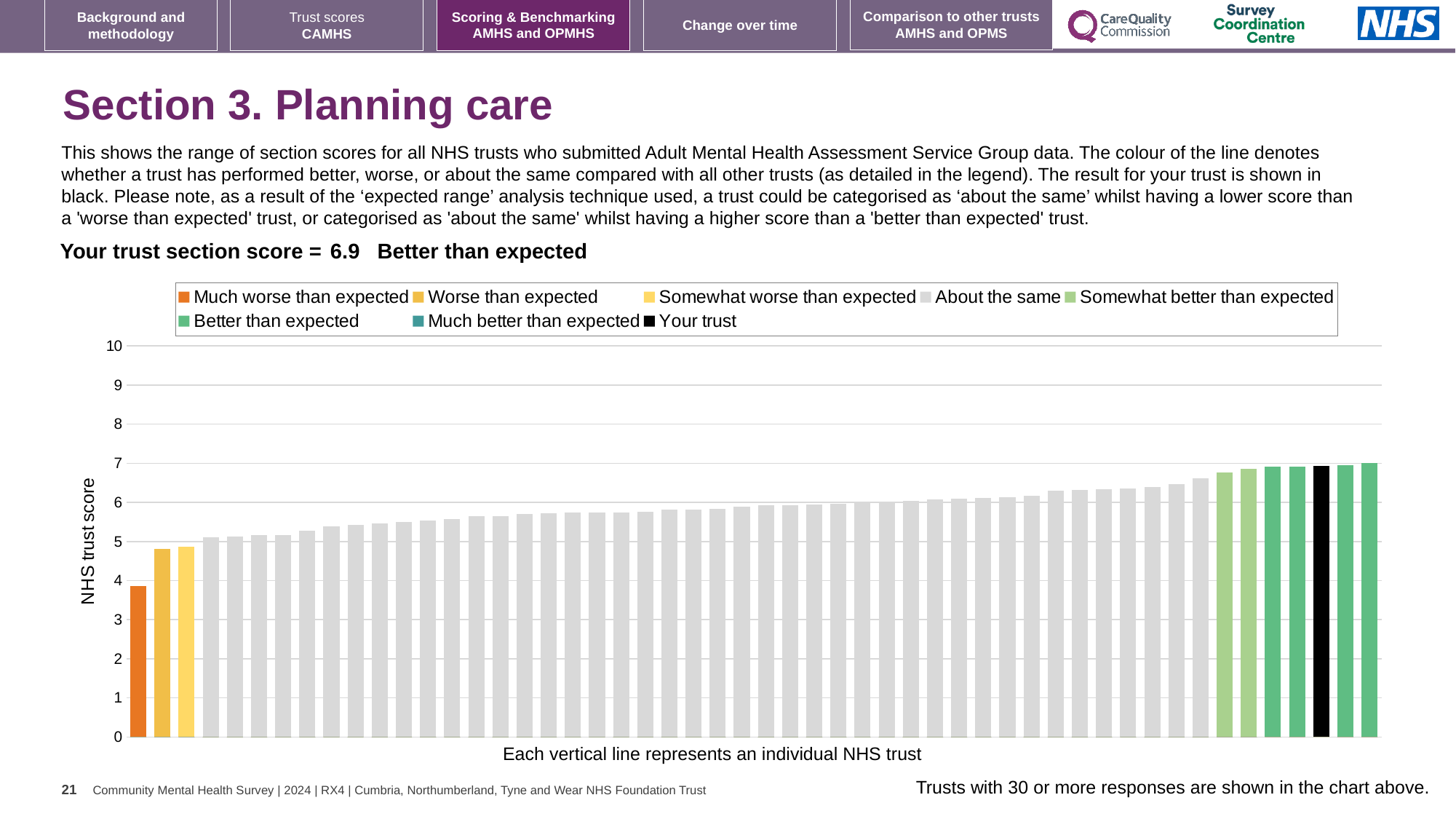
Which performance category is your trust placed in for this section? Better than expected What colour is used for the bar representing your trust? black Which is larger: the bar for your trust or the orange 'Much worse than expected' bar? your trust Is the value of the rightmost bar greater or less than 6? greater Do the bar values rise or fall from left to right along the x axis? rise Is the value for your trust's bar greater or less than 6? greater What kind of chart is shown on the slide? bar chart Is the value of the leftmost (orange) bar greater or less than 5? less How many entries does the chart legend list? 8 Which legend category does the lowest bar belong to? Much worse than expected What is the label on the vertical axis of the chart? NHS trust score What is the section score for your trust? 6.9